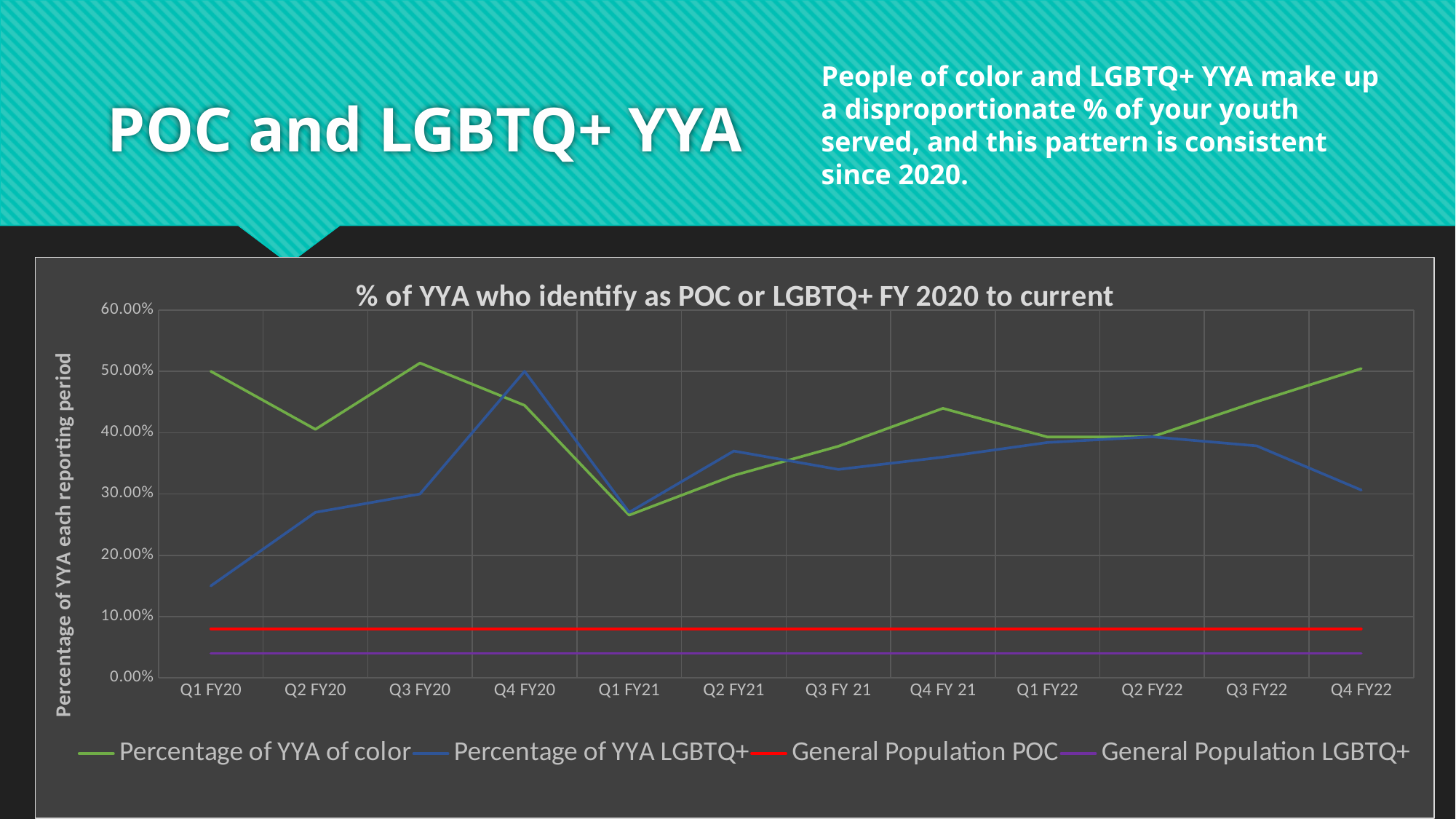
In which reporting period is the Percentage of YYA LGBTQ+ lowest? Q1 FY20 Is the General Population POC line greater or less than 10.00%? less What is the title of the chart? % of YYA who identify as POC or LGBTQ+ FY 2020 to current In which reporting period is the Percentage of YYA LGBTQ+ highest? Q4 FY20 What kind of chart is shown on the slide? line chart In which reporting period is the Percentage of YYA of color lowest? Q1 FY21 How many reporting periods are shown on the x axis? 12 How many series does the legend list? 4 Is the Percentage of YYA LGBTQ+ in Q1 FY20 greater or less than 20.00%? less Does the Percentage of YYA LGBTQ+ rise or fall from Q1 FY20 to Q4 FY20? rise In Q4 FY20, which is larger: the Percentage of YYA of color or the Percentage of YYA LGBTQ+? Percentage of YYA LGBTQ+ Which colour is used for the General Population POC line? red